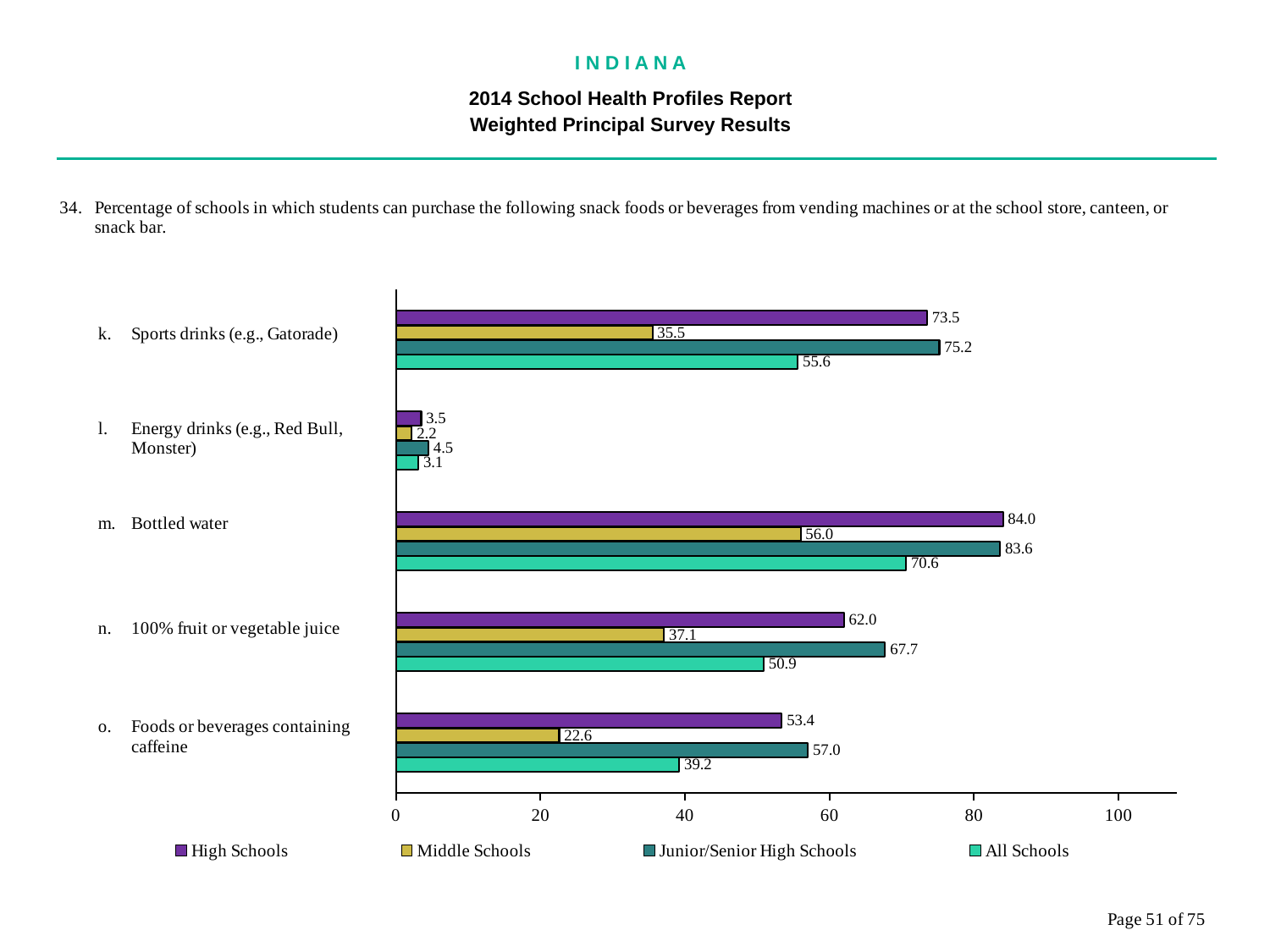
How many categories are shown on the chart? 5 What is the value for Junior/Senior High Schools for 100% fruit or vegetable juice? 67.7 What is the value for High Schools for Bottled water? 84.0 Which category has the lowest value for Middle Schools? Energy drinks (e.g., Red Bull, Monster) Which category has the highest value for All Schools? Bottled water What is the difference between the High Schools and Middle Schools values for Bottled water? 28.0 What is the value for Middle Schools for Sports drinks (e.g., Gatorade)? 35.5 Which is larger for Sports drinks (e.g., Gatorade): the High Schools value or the Junior/Senior High Schools value? Junior/Senior High Schools What kind of chart is shown on the slide? Bar chart How many series does the legend list? 4 Which legend entry is shown in purple? High Schools What is the value for All Schools for Foods or beverages containing caffeine? 39.2